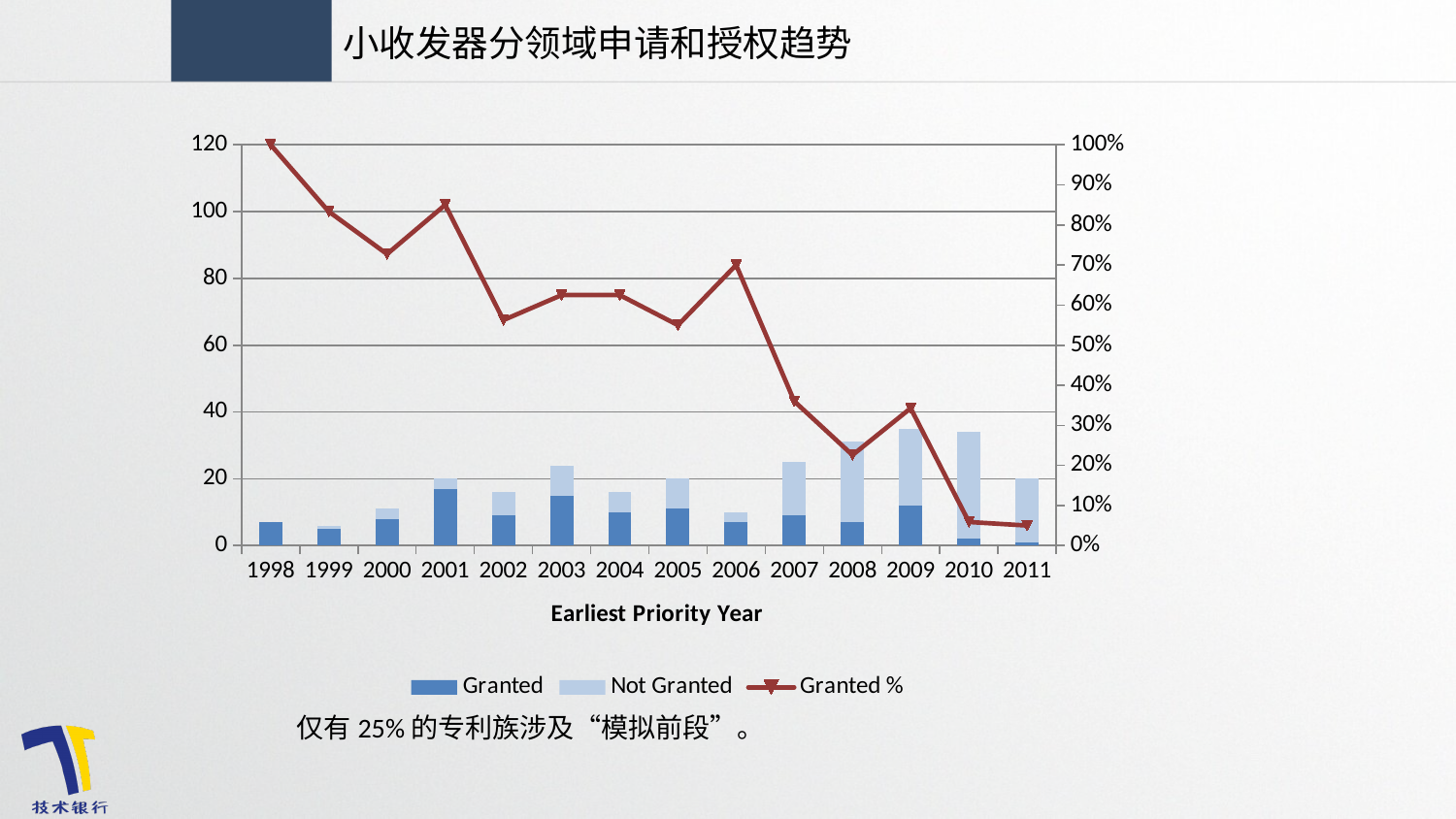
How many series does the chart's legend list? 3 Does the Granted % line generally rise or fall from 1998 to 2011? Fall How many years are shown on the x axis of the chart? 14 What are the three series listed in the legend? Granted, Not Granted, Granted % What is the title of the x axis? Earliest Priority Year Is the Granted % for 2010 greater or less than 10%? less Which year has the higher Granted %, 2006 or 2007? 2006 Is the total height of the stacked bar for 2009 greater or less than 20? greater In which year is the Granted % highest? 1998 Is the Granted % for 1998 greater or less than 90%? greater What kind of chart is shown on the slide? A combined bar and line chart